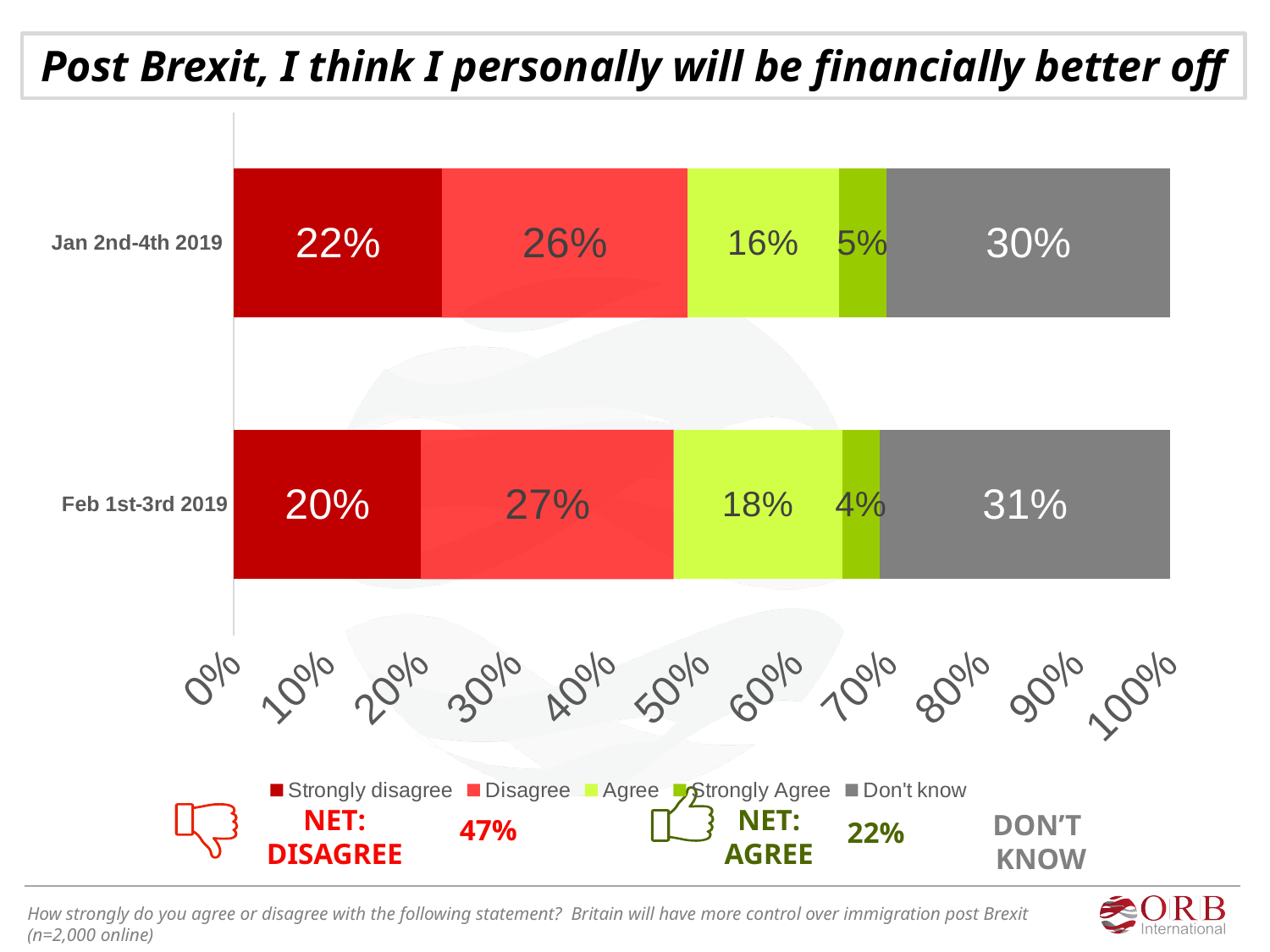
What is the difference between the 'Disagree' values for Feb 1st-3rd 2019 and Jan 2nd-4th 2019? 1% How many series does the legend list? 5 What is the 'Agree' value for Feb 1st-3rd 2019? 18% Which response category has the largest share in the Jan 2nd-4th 2019 bar? Don't know What percentage of respondents said 'Strongly disagree' in the Jan 2nd-4th 2019 survey? 22% What type of chart is shown on the slide? Stacked bar chart Which survey wave has the higher 'Strongly disagree' value, Jan 2nd-4th 2019 or Feb 1st-3rd 2019? Jan 2nd-4th 2019 How many survey waves (bars) are shown in the chart? 2 What percentage of respondents said 'Don't know' in the Feb 1st-3rd 2019 survey? 31% What is the 'Strongly Agree' value for Jan 2nd-4th 2019? 5% Which response category has the smallest share in the Feb 1st-3rd 2019 bar? Strongly Agree What is the combined 'Agree' and 'Strongly Agree' share for Feb 1st-3rd 2019? 22%